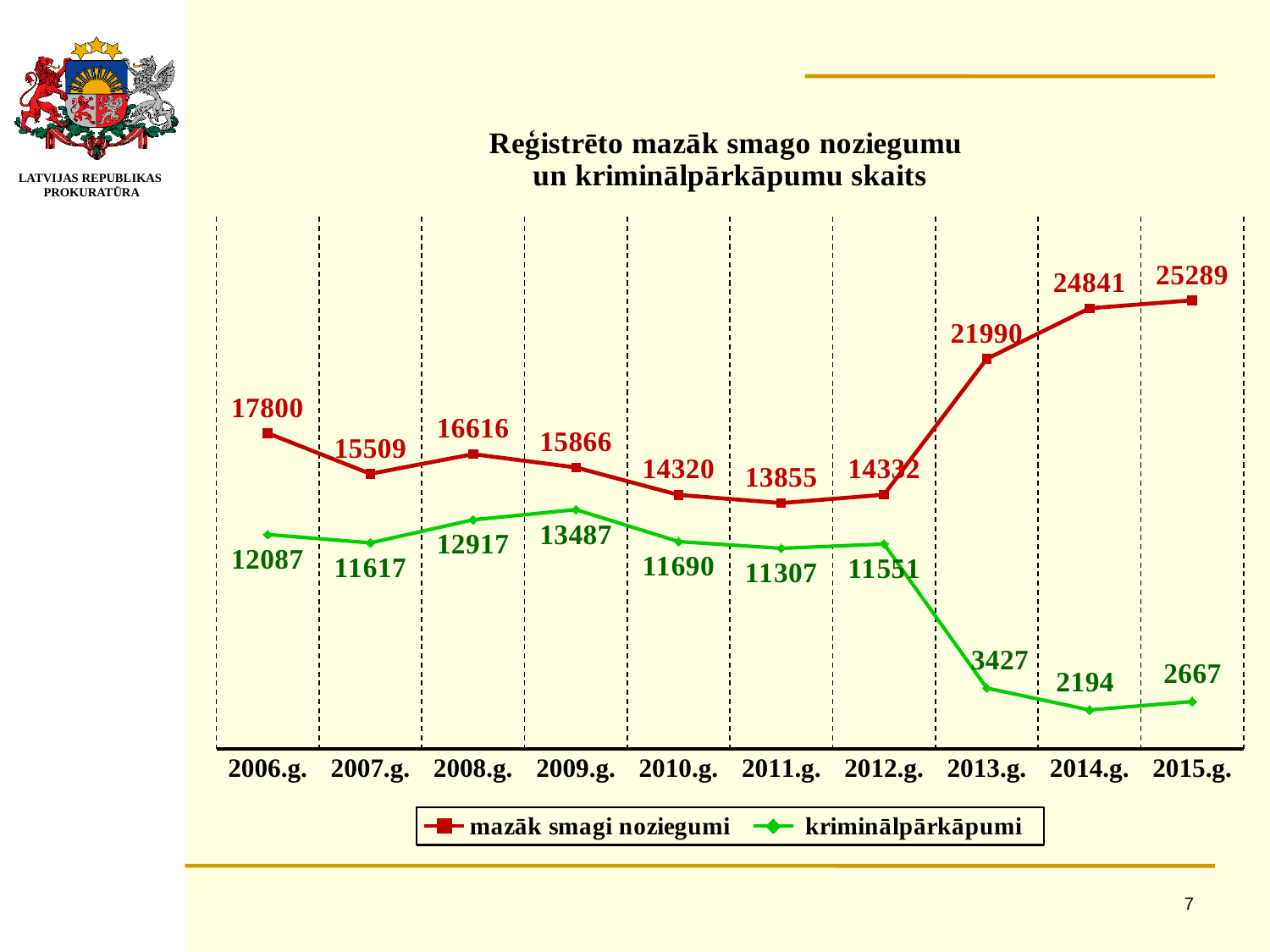
How many series does the legend list? 2 What kind of chart is shown on the slide? line chart Which is larger: the kriminālpārkāpumi value in 2009.g. or in 2008.g.? 2009.g. What is the value for mazāk smagi noziegumi in 2013.g.? 21990 What is the value for kriminālpārkāpumi in 2014.g.? 2194 In which year is the value for kriminālpārkāpumi lowest? 2014.g. What is the value for mazāk smagi noziegumi in 2006.g.? 17800 In which year is the value for mazāk smagi noziegumi highest? 2015.g. What is the title of the chart? Reģistrēto mazāk smago noziegumu un kriminālpārkāpumu skaits How many years are shown on the x axis? 10 Does the kriminālpārkāpumi series rise or fall between 2012.g. and 2013.g.? fall What is the difference between the mazāk smagi noziegumi values for 2015.g. and 2014.g.? 448